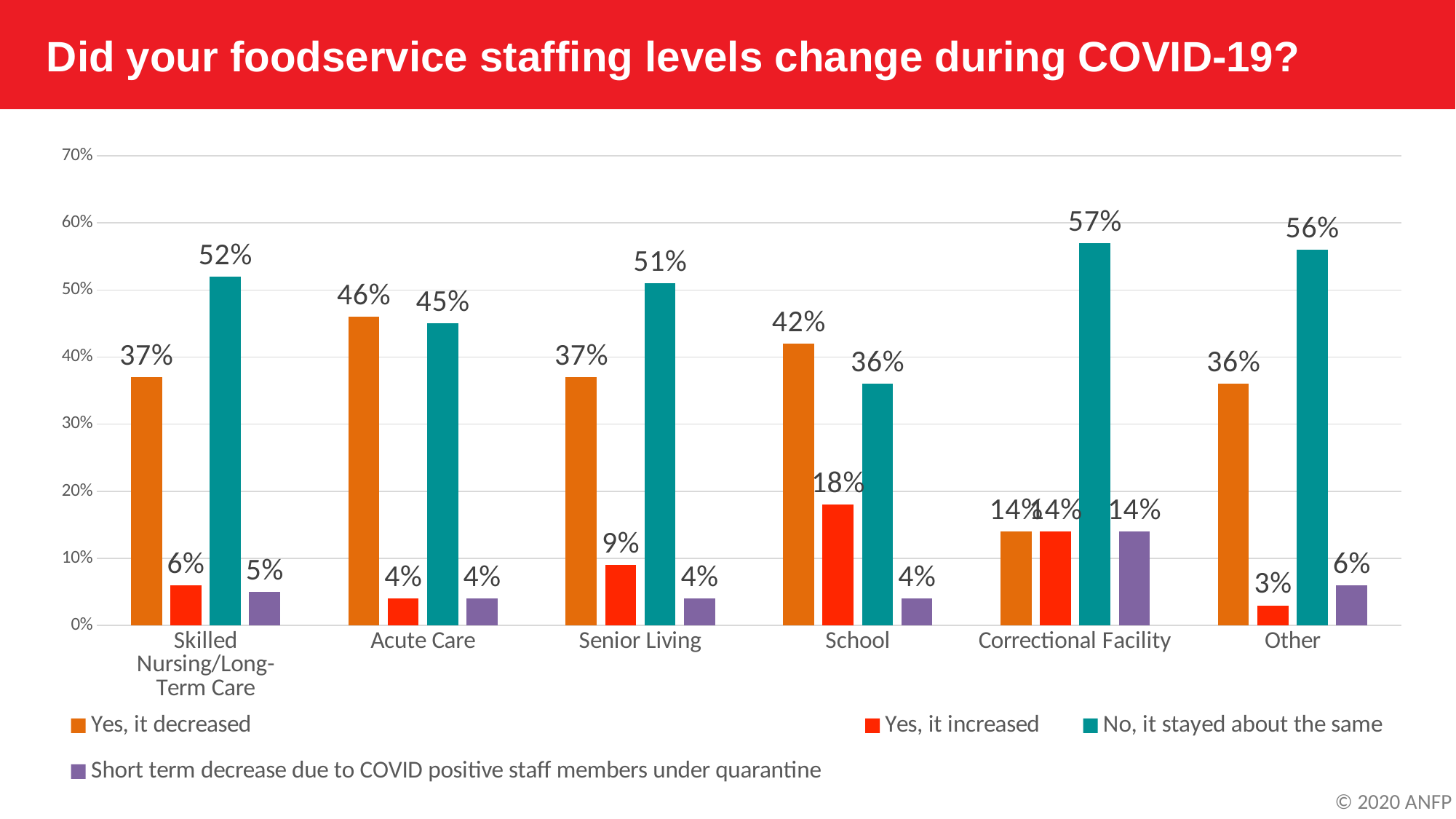
What is the value for 'Yes, it increased' in the School category? 18% Which category has the lowest value for 'Yes, it increased'? Other In the Acute Care category, what is the difference between 'Yes, it decreased' and 'No, it stayed about the same'? 1 percentage point Which category has the highest value for 'No, it stayed about the same'? Correctional Facility What percentage of Skilled Nursing/Long-Term Care respondents said staffing stayed about the same? 52% How many facility categories are shown on the x axis? 6 How many series does the legend list? 4 Which category has the highest value for 'Yes, it decreased'? Acute Care In the School category, which is larger: 'Yes, it decreased' or 'No, it stayed about the same'? Yes, it decreased In the Other category, how much larger is 'No, it stayed about the same' than 'Yes, it decreased'? 20 percentage points What is the value for 'Yes, it increased' in the Senior Living category? 9% What kind of chart is shown on the slide? Bar chart